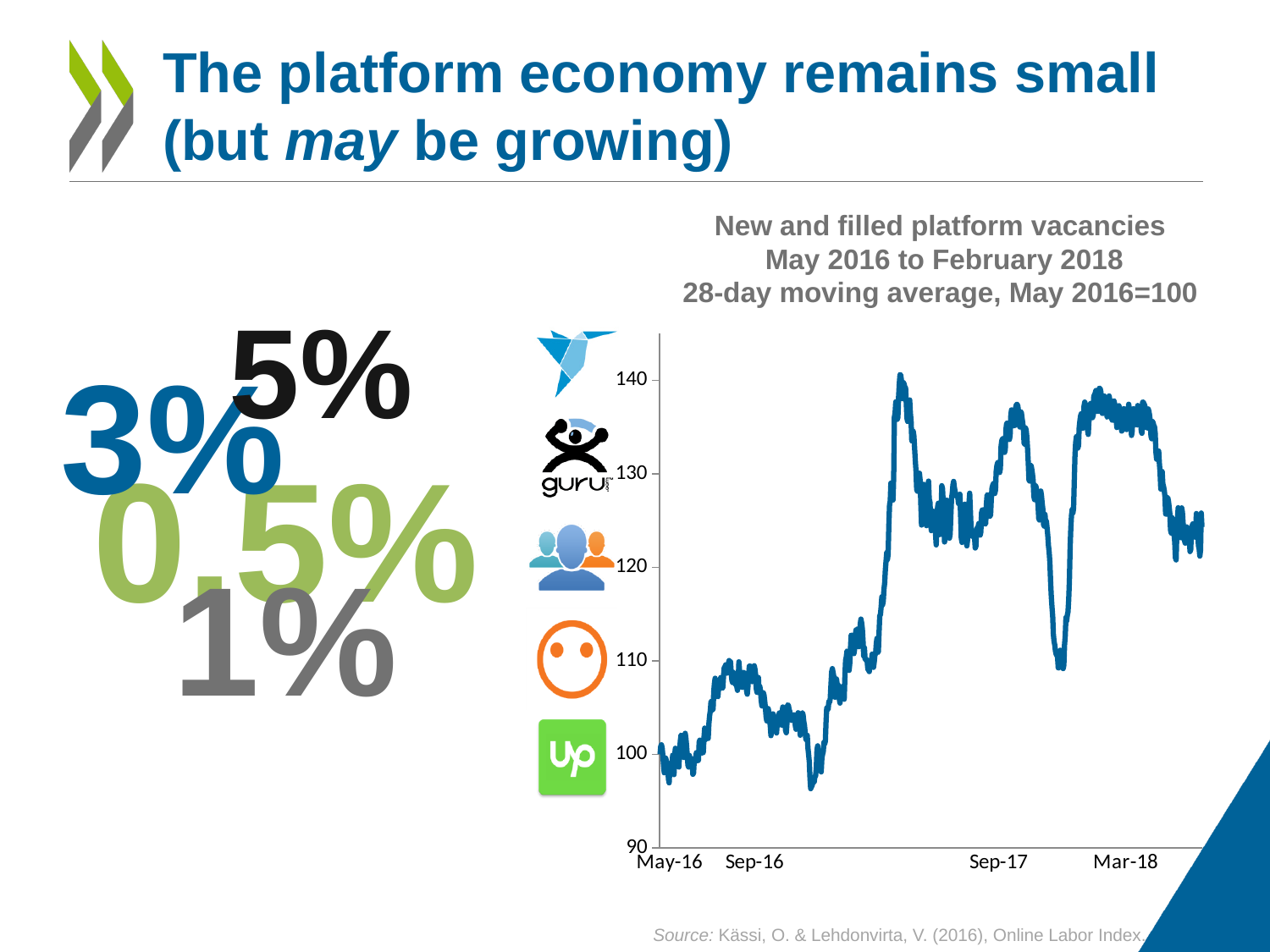
Overall, does the line in the chart rise or fall from May-16 to Mar-18? rise Is the value of the line around Sep-16 greater or less than 100? greater What is the title of the chart on the slide? New and filled platform vacancies May 2016 to February 2018 28-day moving average, May 2016=100 What is the lowest value shown on the chart's vertical axis? 90 Is the lowest point of the line greater or less than 100? less Is the value of the line at the end of the series (early 2018) greater or less than 120? greater How many date labels are shown on the chart's horizontal axis? 4 What base value does the chart's index use for May 2016? 100 What kind of chart is shown on the slide? line chart Which is higher on the chart: the value around Sep-17 or the value around Sep-16? Sep-17